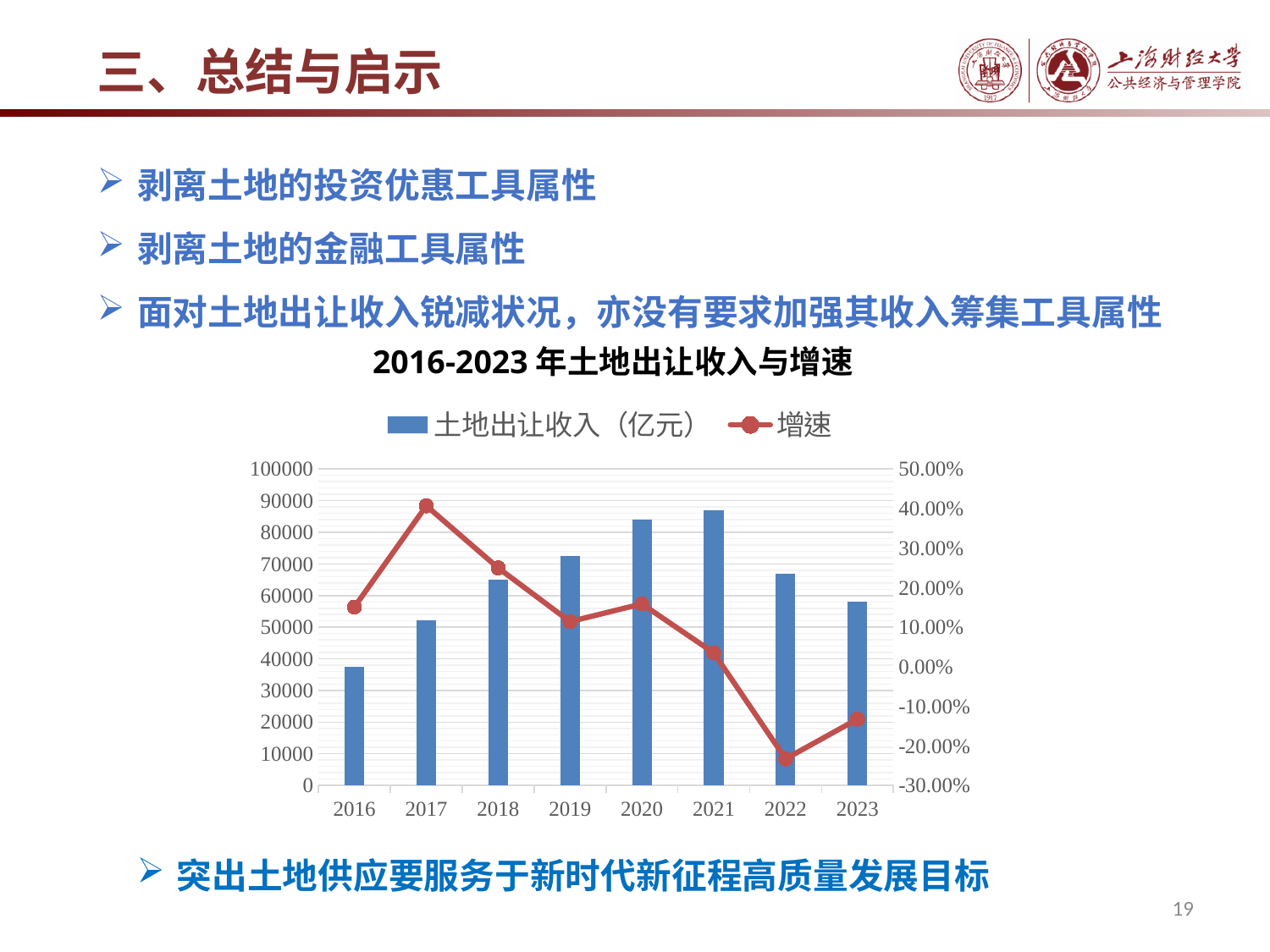
How many years are shown on the x axis of the chart? 8 In which year does the 增速 line reach its highest point? 2017 In which year is the 土地出让收入（亿元） bar the lowest? 2016 How many series does the chart legend list? 2 Is the 增速 value for 2022 greater or less than -20.00%? less Do the 土地出让收入（亿元） bars rise or fall from 2016 to 2021? rise In which year is the 土地出让收入（亿元） bar the highest? 2021 What kind of chart is shown on the slide? Combined bar and line chart In which year does the 增速 line reach its lowest point? 2022 Which year has the larger 土地出让收入（亿元） bar, 2018 or 2023? 2018 What is the title of the chart? 2016-2023 年土地出让收入与增速 Is the 土地出让收入（亿元） value for 2016 greater or less than 40000? less